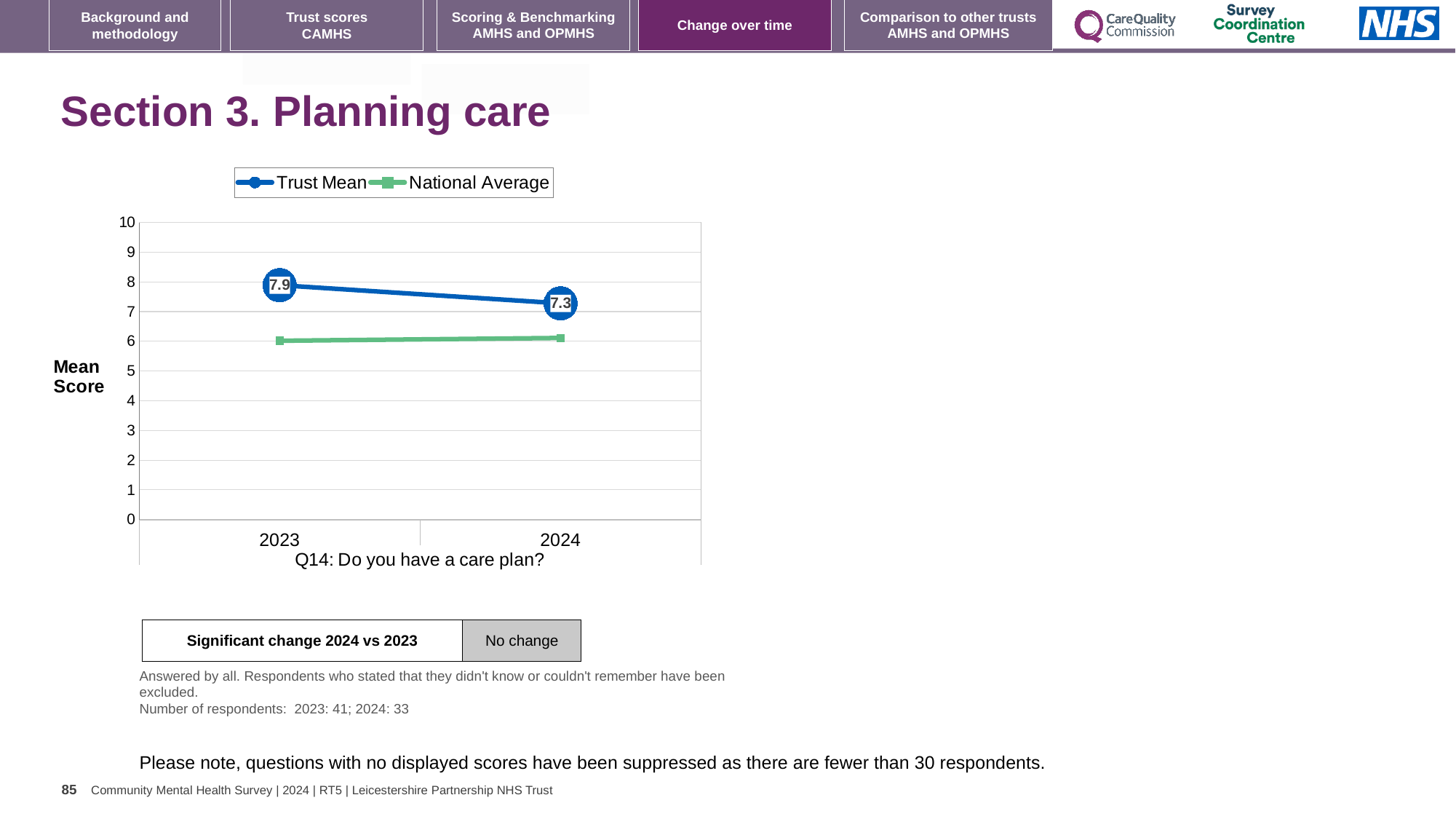
In 2024, which is higher, the Trust Mean or the National Average? Trust Mean What is the Trust Mean score for 2024? 7.3 How many series does the legend list? 2 Is the National Average value for 2024 greater or less than 5? greater What kind of chart is shown on the slide? line chart By how much did the Trust Mean score change from 2023 to 2024? 0.6 What is the Trust Mean score for 2023? 7.9 Which year has the higher Trust Mean score, 2023 or 2024? 2023 How many years are shown on the x axis? 2 Is the National Average value for 2023 greater or less than 7? less Does the Trust Mean line rise or fall from 2023 to 2024? fall Which survey question does the chart relate to? Q14: Do you have a care plan?